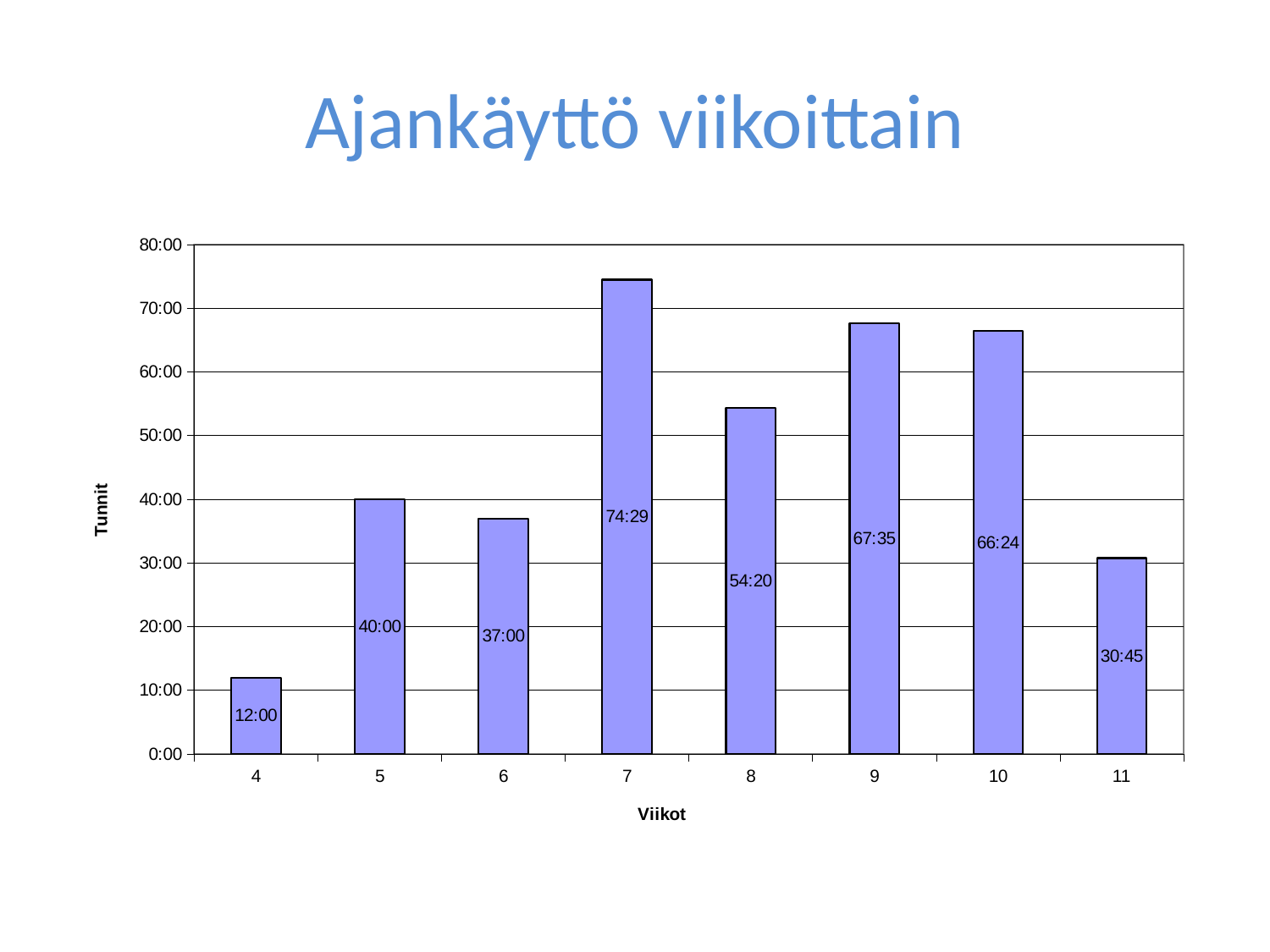
What is the difference between the values for week 5 and week 6? 3:00 Which week has the lowest value? 4 Which week has the highest value? 7 What is the label of the y axis? Tunnit How many weeks are shown on the x axis? 8 Which is larger, the value for week 9 or week 10? week 9 What kind of chart is shown on the slide? bar chart What is the value for week 7? 74:29 Is the value for week 8 greater or less than 50:00? greater What is the value for week 11? 30:45 Do the values rise or fall from week 9 to week 11? fall What is the value for week 8? 54:20